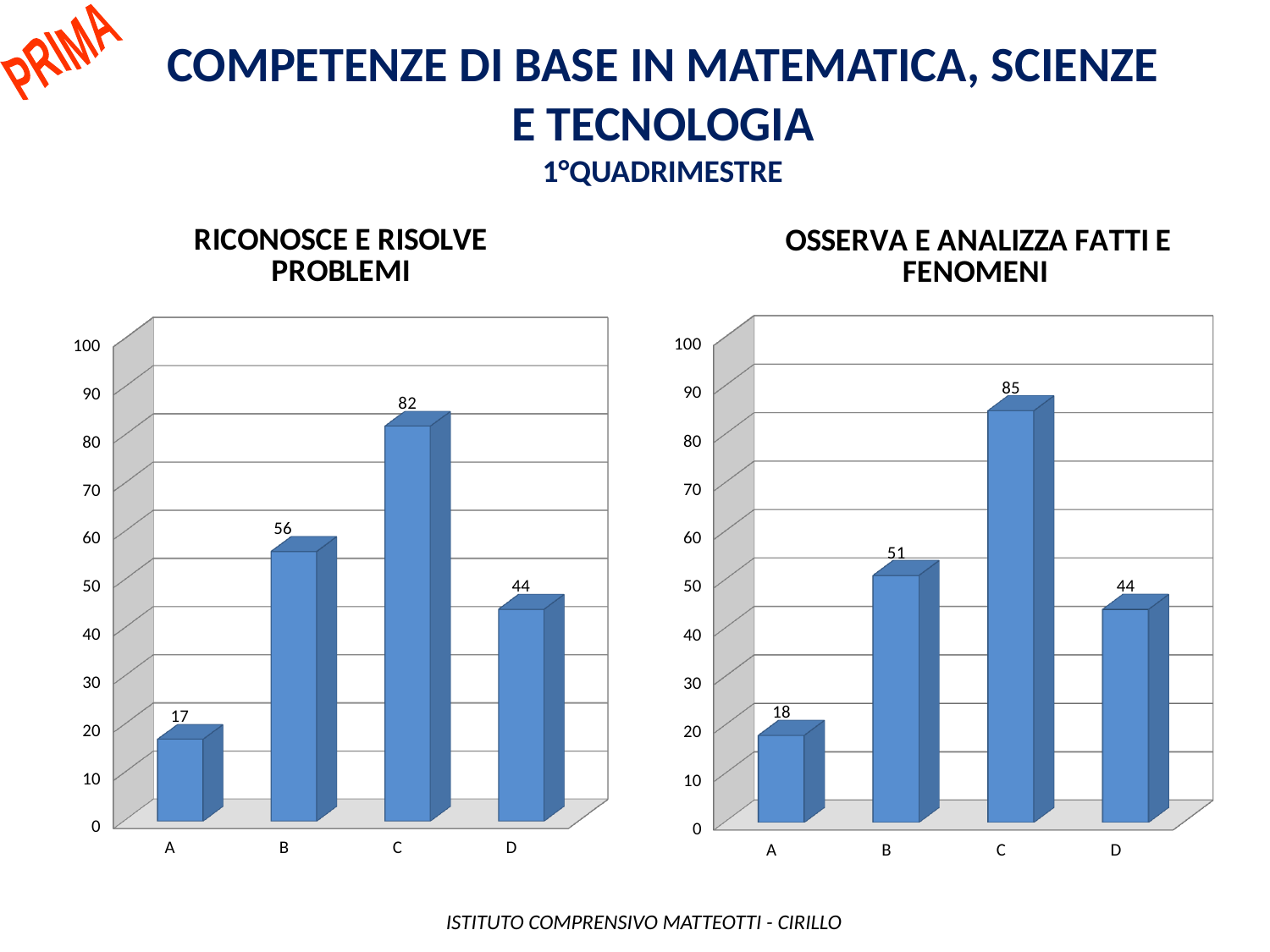
How many categories are shown in the 'RICONOSCE E RISOLVE PROBLEMI' chart? 4 In the 'OSSERVA E ANALIZZA FATTI E FENOMENI' chart, is the value for C greater or less than 80? greater In the 'RICONOSCE E RISOLVE PROBLEMI' chart, which is larger, the value for B or the value for D? B In the 'RICONOSCE E RISOLVE PROBLEMI' chart, what is the value for category A? 17 What kind of chart is the 'OSSERVA E ANALIZZA FATTI E FENOMENI' chart? Bar chart In the 'RICONOSCE E RISOLVE PROBLEMI' chart, what is the value for category C? 82 In the 'RICONOSCE E RISOLVE PROBLEMI' chart, what is the difference between the values for C and B? 26 In the 'OSSERVA E ANALIZZA FATTI E FENOMENI' chart, what is the value for category B? 51 In the 'RICONOSCE E RISOLVE PROBLEMI' chart, which category has the lowest value? A In the 'OSSERVA E ANALIZZA FATTI E FENOMENI' chart, which category has the highest value? C In the 'OSSERVA E ANALIZZA FATTI E FENOMENI' chart, what is the difference between the values for D and A? 26 What is the title of the chart on the right side of the slide? OSSERVA E ANALIZZA FATTI E FENOMENI